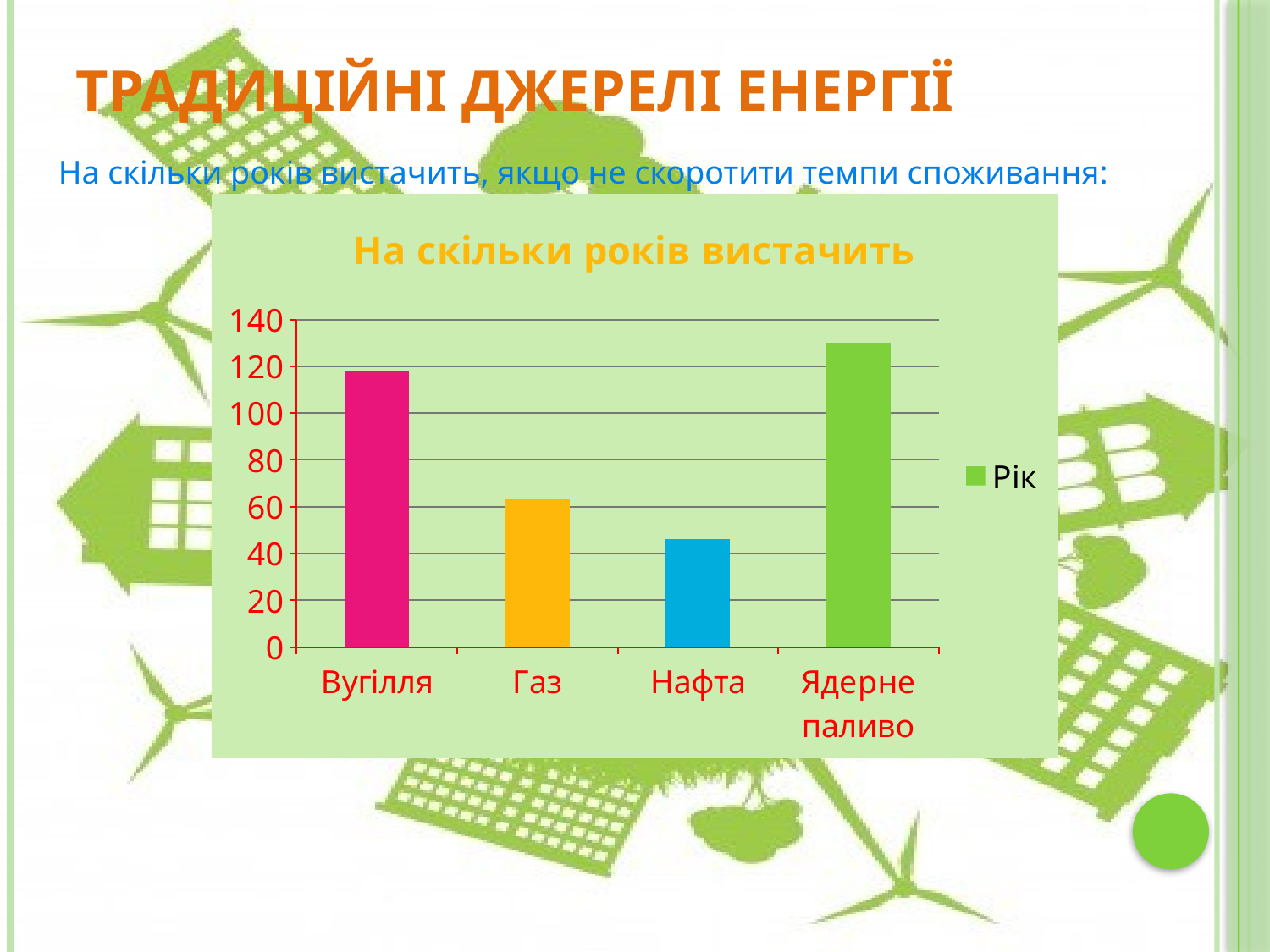
Is the value for Вугілля greater or less than 100? greater Which has a larger value, Вугілля or Газ? Вугілля Which category has the highest value in the chart? Ядерне паливо How many categories are shown on the x axis of the chart? 4 How many series does the chart legend list? 1 What is the title of the chart? На скільки років вистачить Which has a larger value, Газ or Нафта? Газ Is the value for Газ greater or less than 80? less What kind of chart is shown on the slide? bar chart Is the value for Ядерне паливо greater or less than 120? greater Which category has the lowest value in the chart? Нафта